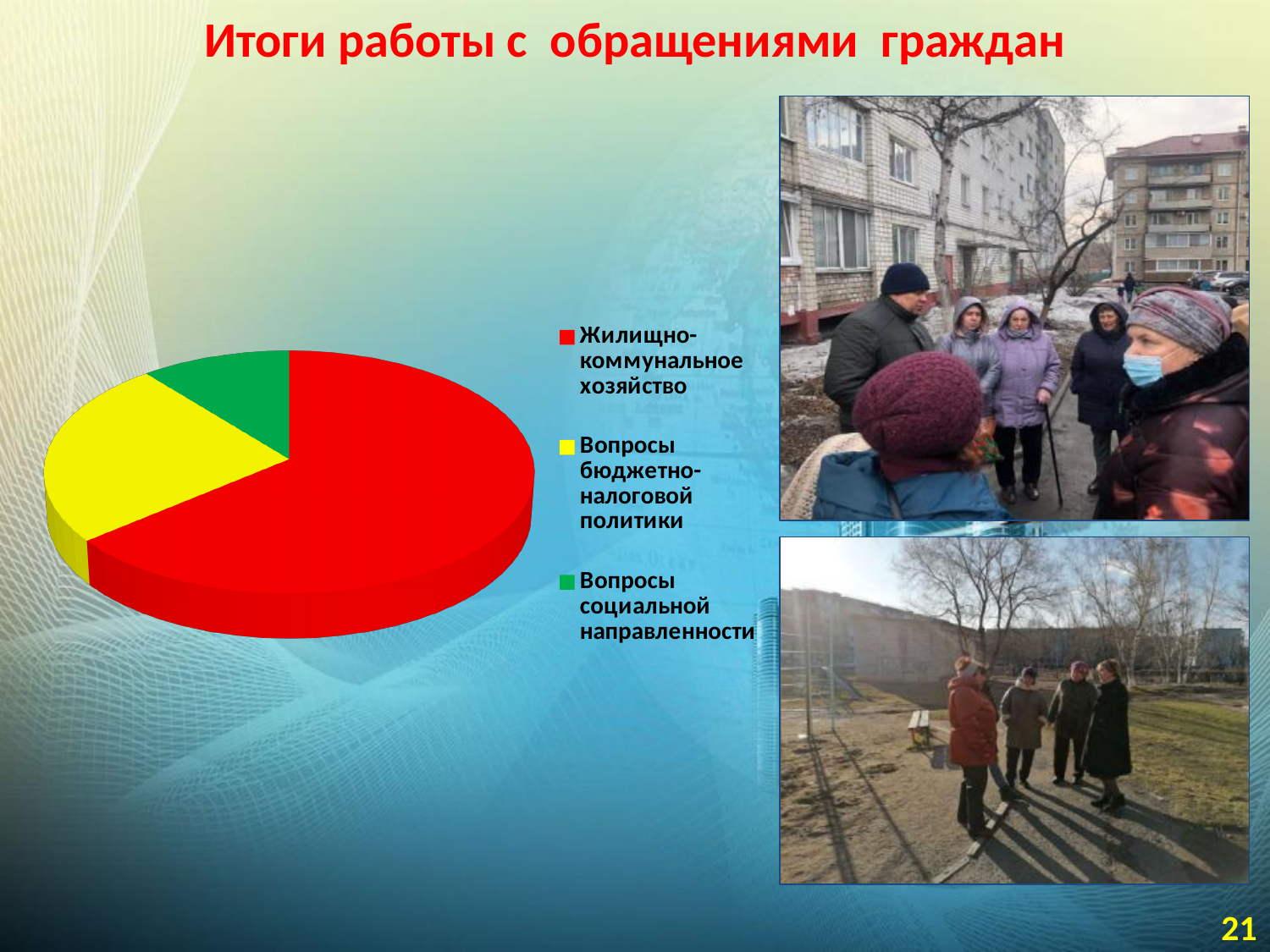
What kind of chart is shown on the slide? pie chart Which slice is larger: Жилищно-коммунальное хозяйство or Вопросы бюджетно-налоговой политики? Жилищно-коммунальное хозяйство Which slice is larger: Вопросы бюджетно-налоговой политики or Вопросы социальной направленности? Вопросы бюджетно-налоговой политики How many slices does the pie chart have? 3 Which category is shown in red in the pie chart? Жилищно-коммунальное хозяйство What colour is the slice for Вопросы социальной направленности in the pie chart? green Which category has the smallest slice in the pie chart? Вопросы социальной направленности Which category has the largest slice in the pie chart? Жилищно-коммунальное хозяйство How many entries does the legend of the pie chart list? 3